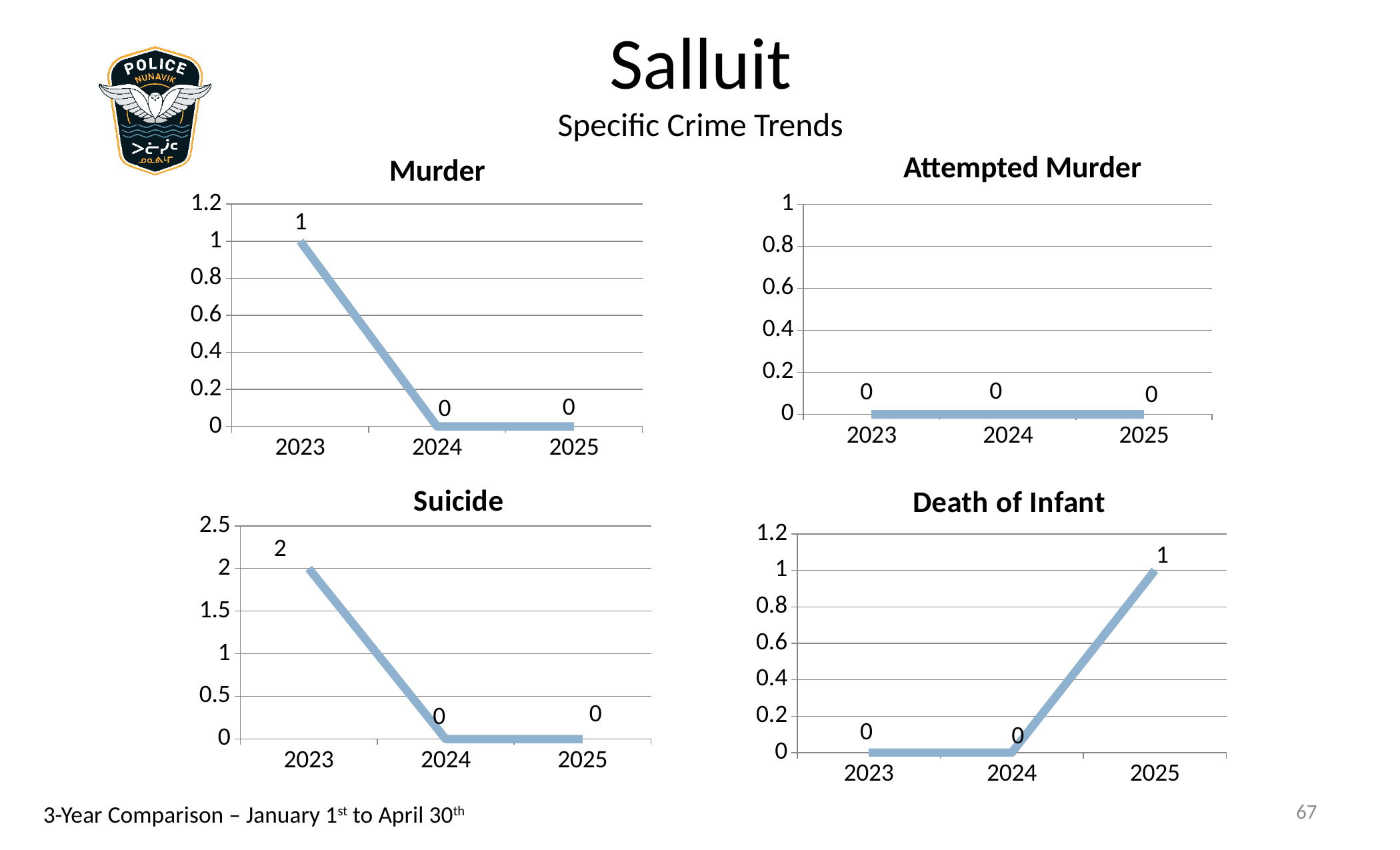
What kind of chart is the Suicide chart? line chart In the Murder chart, what is the value for 2024? 0 In the Suicide chart, what is the difference between the 2023 and 2024 values? 2 In the Suicide chart, what is the value for 2023? 2 In the Attempted Murder chart, what is the value for 2024? 0 In the Death of Infant chart, do the values rise or fall from 2024 to 2025? rise How many years are plotted in the Death of Infant chart? 3 In the Murder chart, which is larger, the value for 2023 or the value for 2025? 2023 In the Death of Infant chart, which year has the highest value? 2025 In the Murder chart, what is the value for 2023? 1 In the Death of Infant chart, what is the value for 2025? 1 In the Suicide chart, which year has the highest value? 2023